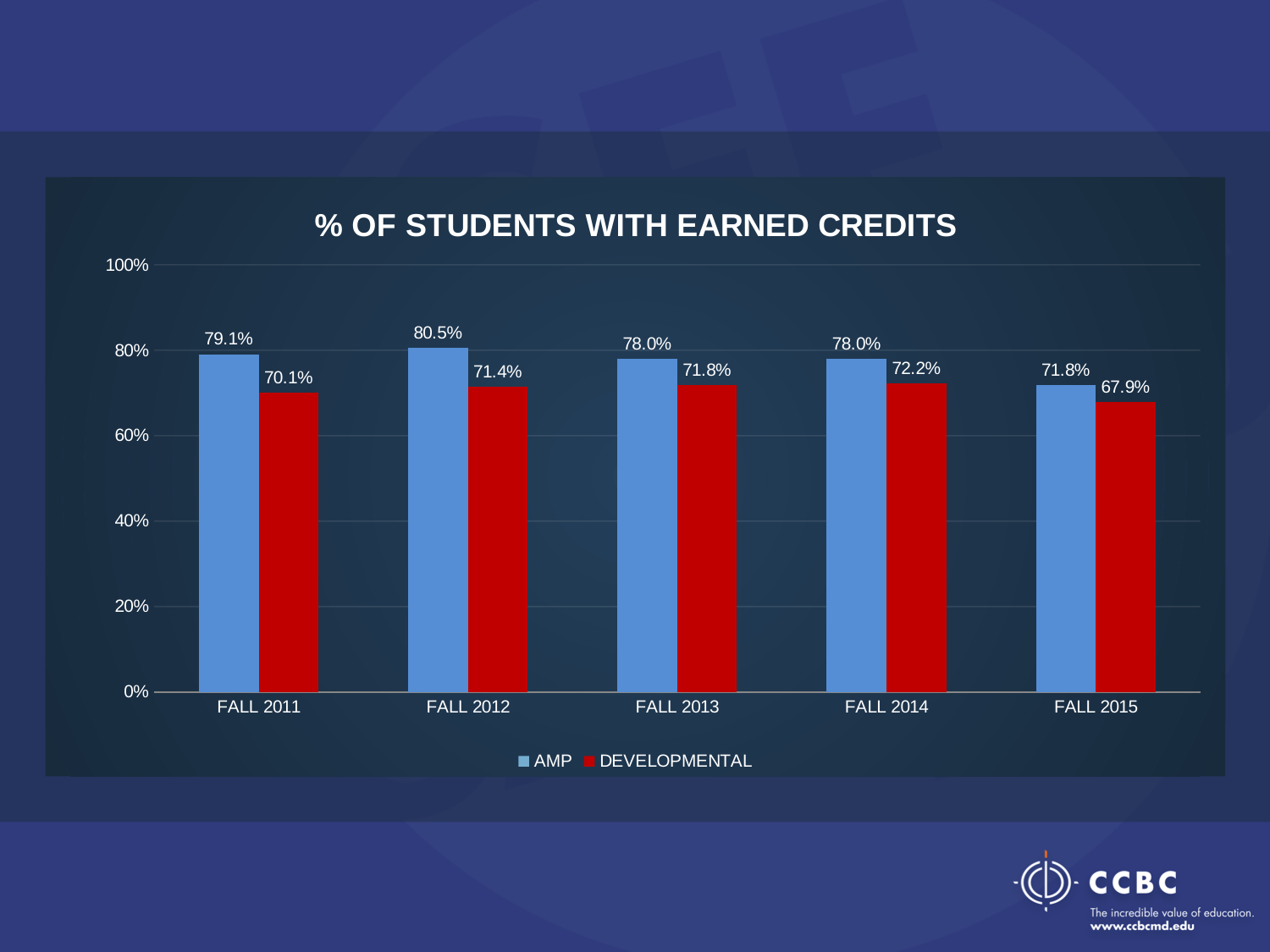
What is the DEVELOPMENTAL value for FALL 2015? 67.9% What is the DEVELOPMENTAL value for FALL 2011? 70.1% What is the difference between the AMP and DEVELOPMENTAL values for FALL 2011? 9.0% What is the AMP value for FALL 2012? 80.5% Is the AMP value for FALL 2015 greater or less than 80%? less What kind of chart is shown on the slide? bar chart How many terms are shown on the x axis? 5 How many series does the legend list? 2 Which term has the highest AMP value? FALL 2012 Which term has the lowest DEVELOPMENTAL value? FALL 2015 Which is larger for FALL 2014, the AMP value or the DEVELOPMENTAL value? AMP What is the title of the chart? % OF STUDENTS WITH EARNED CREDITS